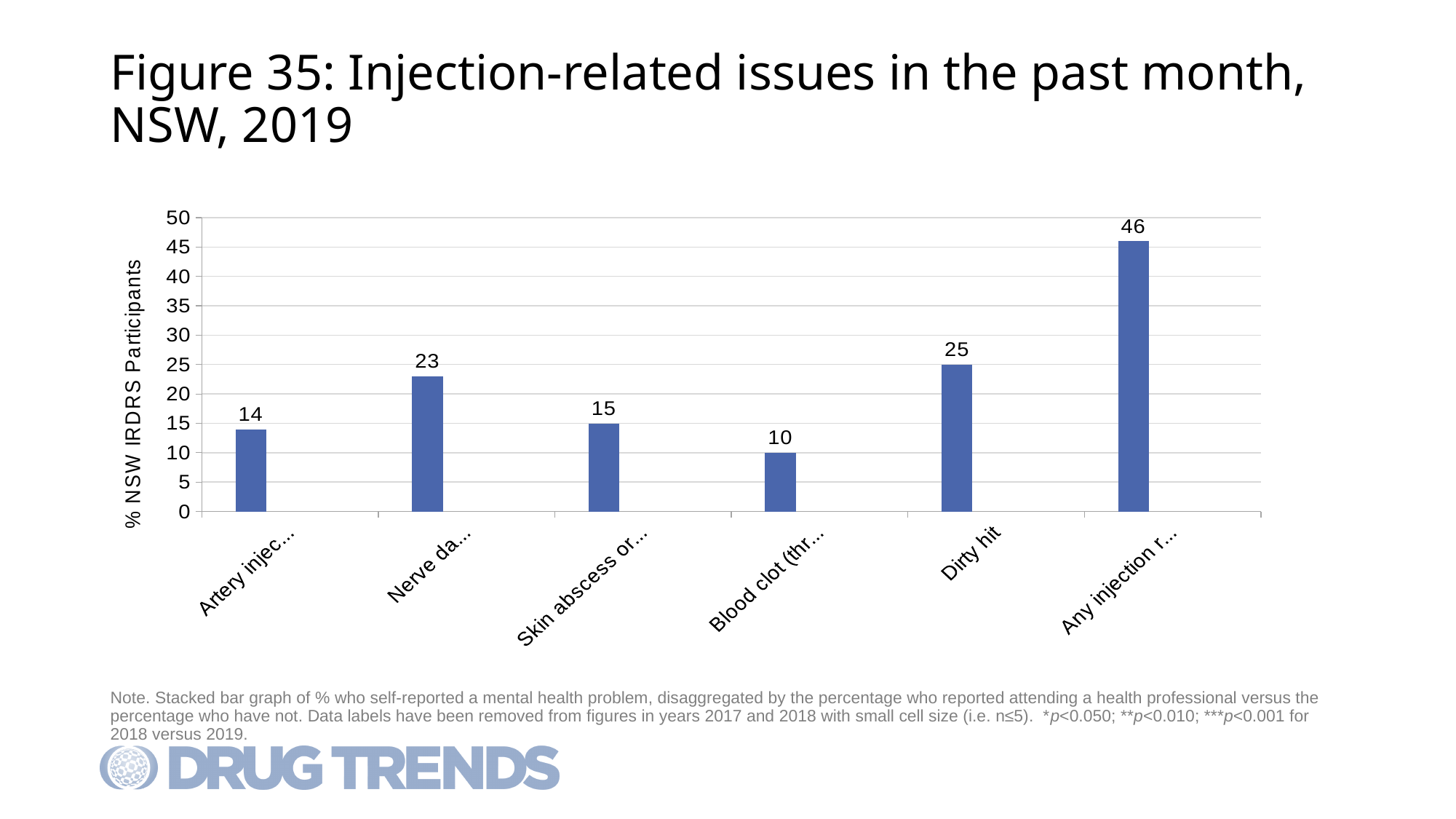
Which bar has the lowest value? The fourth bar (Blood clot (thr...) How many bars are shown in the chart? 6 What is the y-axis label of the chart? % NSW IRDRS Participants What kind of chart is this? Bar chart What is the value of the fourth bar from the left? 10 Which is larger, the value for Dirty hit or the value of the second bar? Dirty hit What is the value for Dirty hit? 25 What is the difference between the value for Dirty hit and the value of the first bar? 11 What is the value of the last (rightmost) bar? 46 Which bar has the highest value? The rightmost bar (Any injection r...) What is the value of the first (leftmost) bar? 14 What is the difference between the highest and lowest bar values? 36